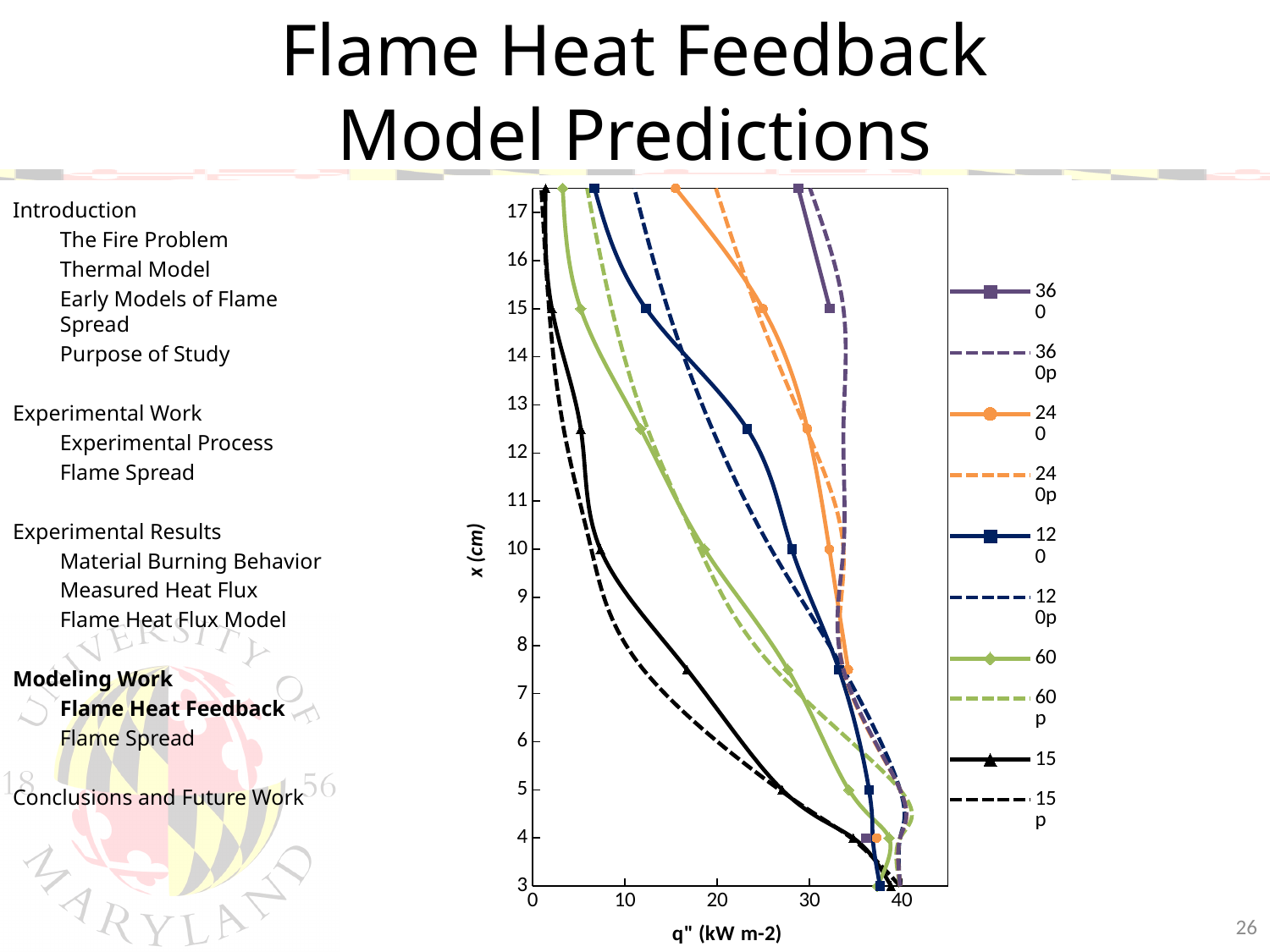
At x = 15 cm, which series has the larger value, 360 or 120? 360 What is the title of the horizontal axis? q" (kW m-2) At x = 17 cm, is the value for series 15 greater or less than 10? less At x = 15 cm, is the value for series 120 greater or less than 20? less At x = 17 cm, is the value for series 360 greater or less than 20? greater How many series does the legend list? 10 What kind of chart is shown on the slide? line chart Does the value for series 15 increase or decrease as x increases from 3 cm to 17 cm? decrease What is the title of the vertical axis? x (cm) At x = 10 cm, which series has the larger value, 240 or 60? 240